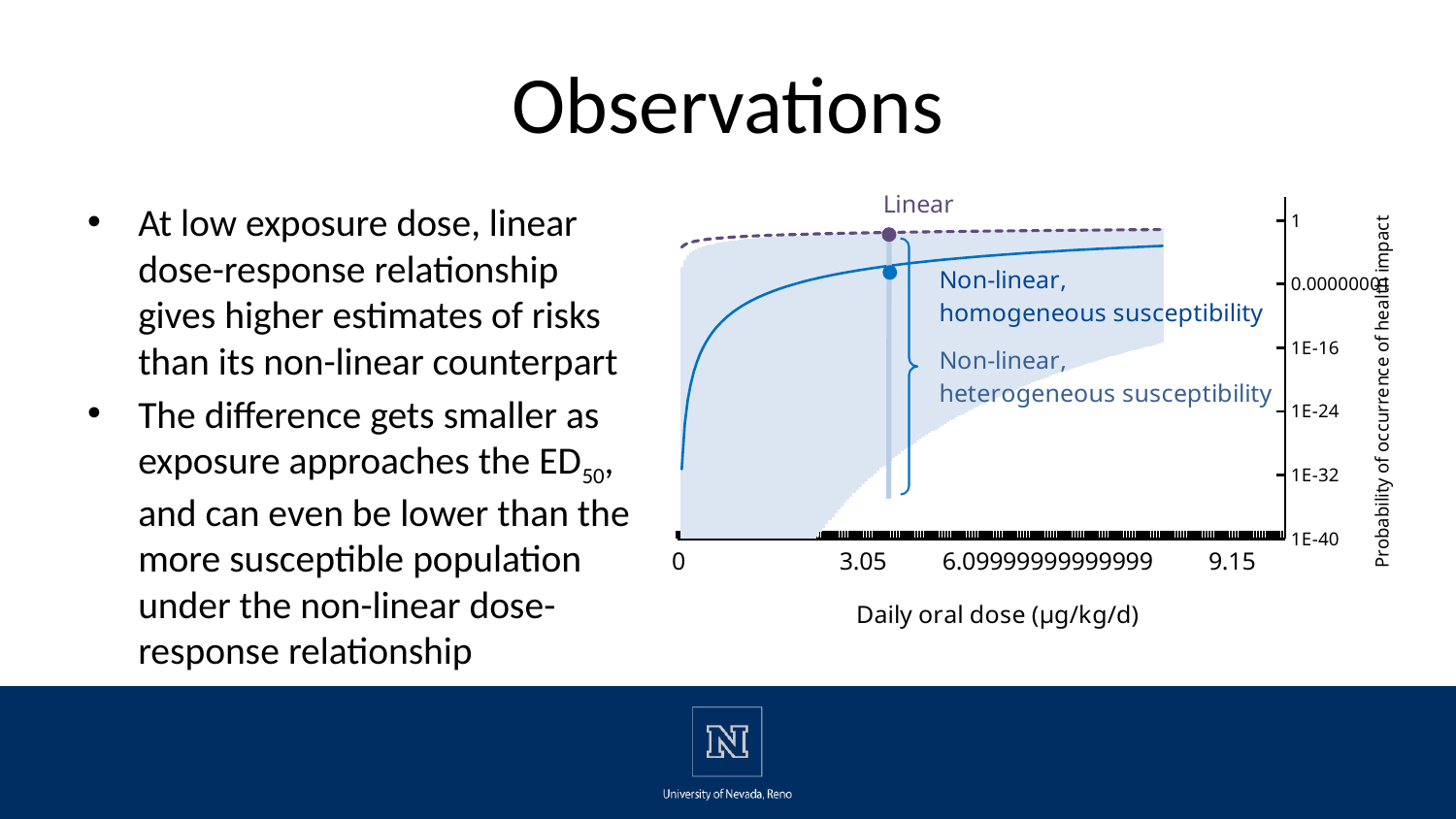
What is the largest tick value shown on the x axis of the chart? 9.15 What is the highest tick value shown on the y axis of the chart? 1 How many labelled series (lines or bands) are shown in the chart? 3 What is the title of the y axis of the chart? Probability of occurrence of health impact How many tick labels are shown on the x axis of the chart? 4 Which series is drawn as a dashed line in the chart? Linear What is the lowest tick value shown on the y axis of the chart? 1E-40 What is the title of the x axis of the chart? Daily oral dose (µg/kg/d) Is the value of the Linear line at a daily oral dose of 3.05 greater or less than 1E-16? greater What kind of chart is shown on the slide? line chart Does the solid 'Non-linear, homogeneous susceptibility' line rise or fall as daily oral dose increases? rise At a daily oral dose of about 1 µg/kg/d, which is higher: the Linear line or the Non-linear, homogeneous susceptibility line? Linear